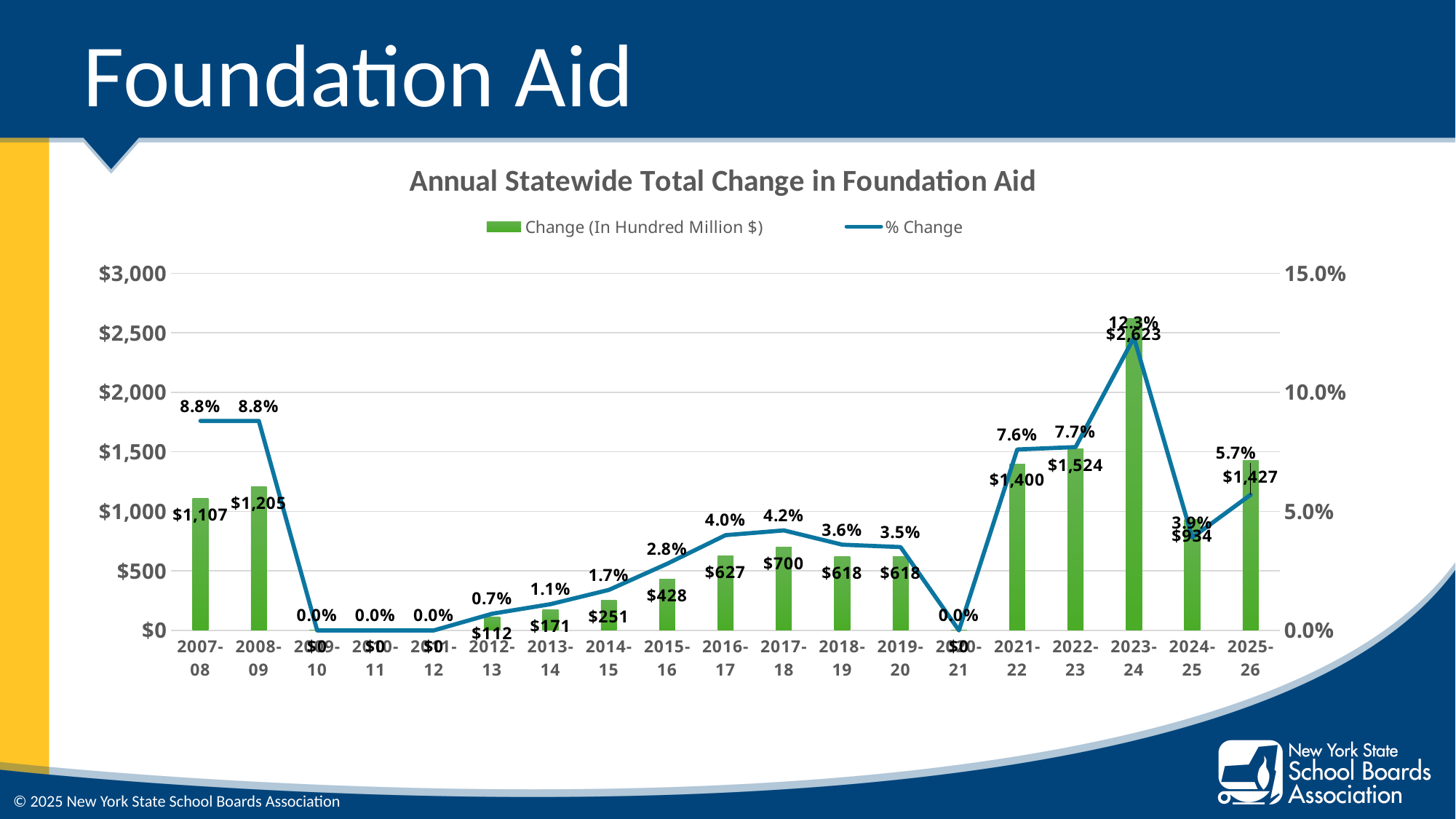
Which year has the highest Change (In Hundred Million $) value? 2023-24 What is the Change (In Hundred Million $) value for 2015-16? $428 How many series does the legend list? 2 How many years are shown on the x axis of the chart? 19 What kind of chart is used to show the Change (In Hundred Million $) series? Bar chart Which is larger, the Change value for 2008-09 or for 2007-08? 2008-09 What is the difference between the Change values for 2022-23 and 2021-22? $124 What is the Change (In Hundred Million $) value for 2023-24? $2,623 What is the % Change value for 2016-17? 4.0% What is the highest % Change value shown on the chart? 12.3% Does the % Change rise or fall from 2023-24 to 2024-25? Fall What is the title of the chart? Annual Statewide Total Change in Foundation Aid